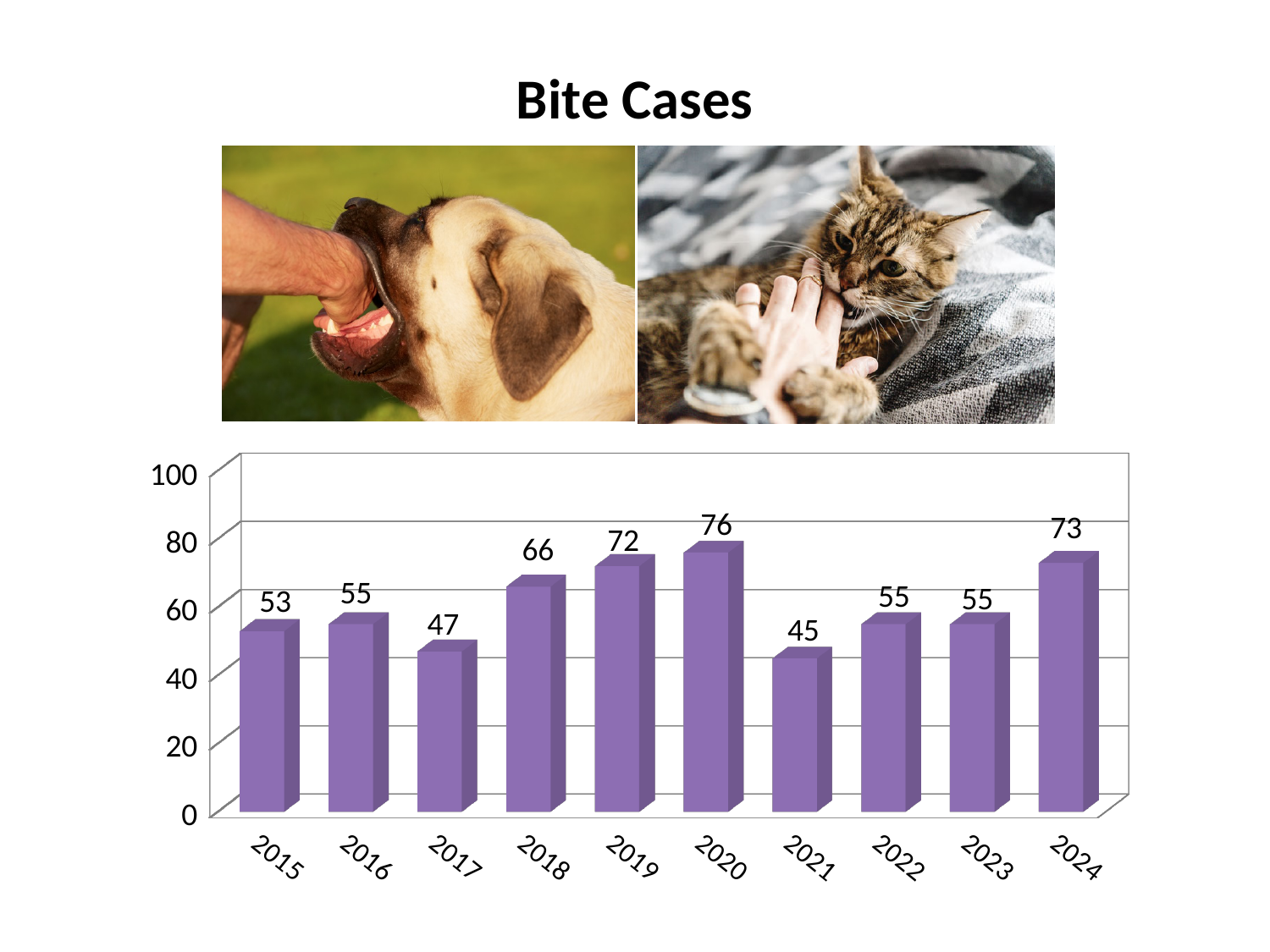
What is the value for 2020? 76 What is the difference between the values for 2019 and 2018? 6 Which is larger, the value for 2015 or the value for 2018? 2018 What is the value for 2024? 73 What kind of chart is shown on the slide? bar chart Is the value for 2019 greater or less than 60? greater How many years are shown on the x axis? 10 What is the difference between the values for 2020 and 2021? 31 What is the title of the slide? Bite Cases Which year has the lowest value? 2021 What is the value for 2017? 47 Which year has the highest value? 2020